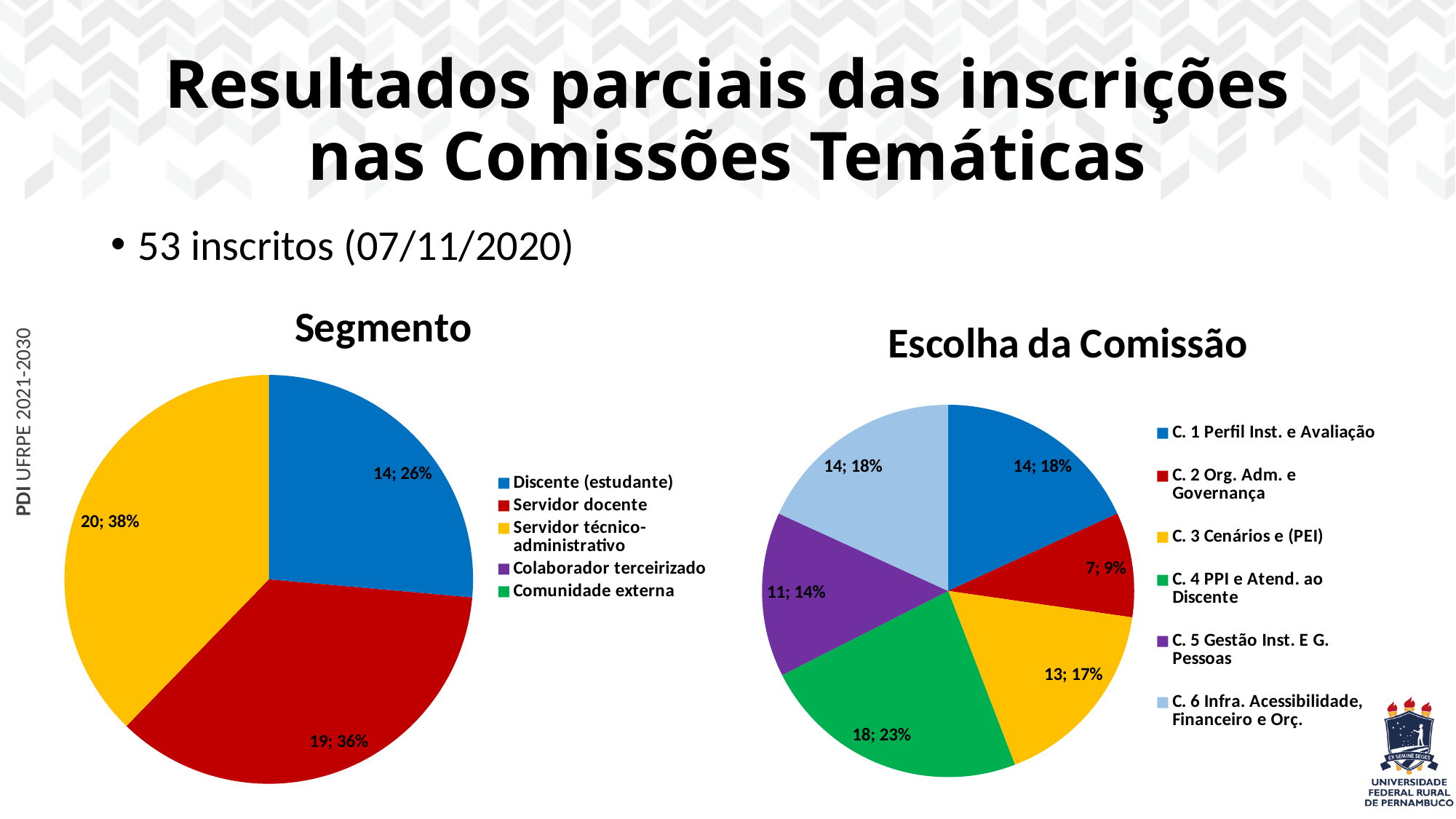
In the Segmento chart, what percentage share does Servidor técnico-administrativo have? 38% In the Escolha da Comissão chart, what is the difference in count between C. 4 PPI e Atend. ao Discente and C. 2 Org. Adm. e Governança? 11 In the Segmento chart, how many inscritos are in the Servidor docente slice? 19 In the Escolha da Comissão chart, what percentage share does C. 3 Cenários e (PEI) have? 17% In the Escolha da Comissão chart, how many commissions does the legend list? 6 In the Segmento chart, what is the difference in count between Servidor técnico-administrativo and Discente (estudante)? 6 In the Escolha da Comissão chart, how many inscritos chose C. 4 PPI e Atend. ao Discente? 18 In the Segmento chart, which segment has the largest slice? Servidor técnico-administrativo What type of chart is the Escolha da Comissão chart? Pie chart In the Escolha da Comissão chart, which is larger: C. 5 Gestão Inst. E G. Pessoas or C. 3 Cenários e (PEI)? C. 3 Cenários e (PEI) In the Segmento chart, how many entries does the legend list? 5 In the Escolha da Comissão chart, which commission has the smallest slice? C. 2 Org. Adm. e Governança